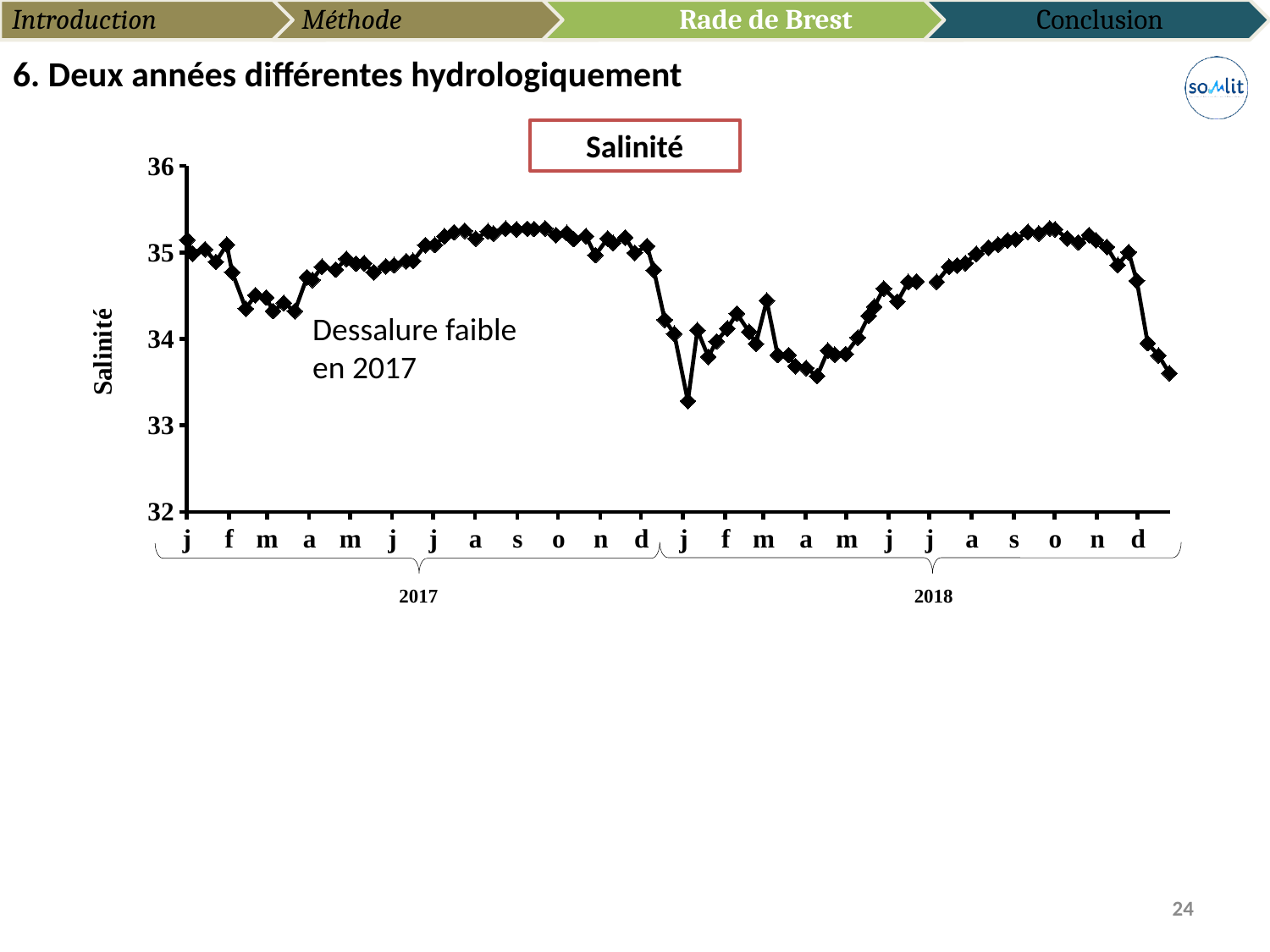
Do salinity values rise or fall from October 2018 to December 2018? fall Is the salinity value in March 2017 greater or less than 35? less Is the salinity value in October 2018 greater or less than 35? greater Is the lowest salinity value in early 2018 greater or less than 34? less Which year shows the lower minimum salinity, 2017 or 2018? 2018 What kind of chart is shown on the slide? line chart Do salinity values rise or fall from April 2017 to August 2017? rise How many years of data does the chart cover? 2 What is the label on the vertical axis of the chart? Salinité What is the title shown in the box above the chart? Salinité